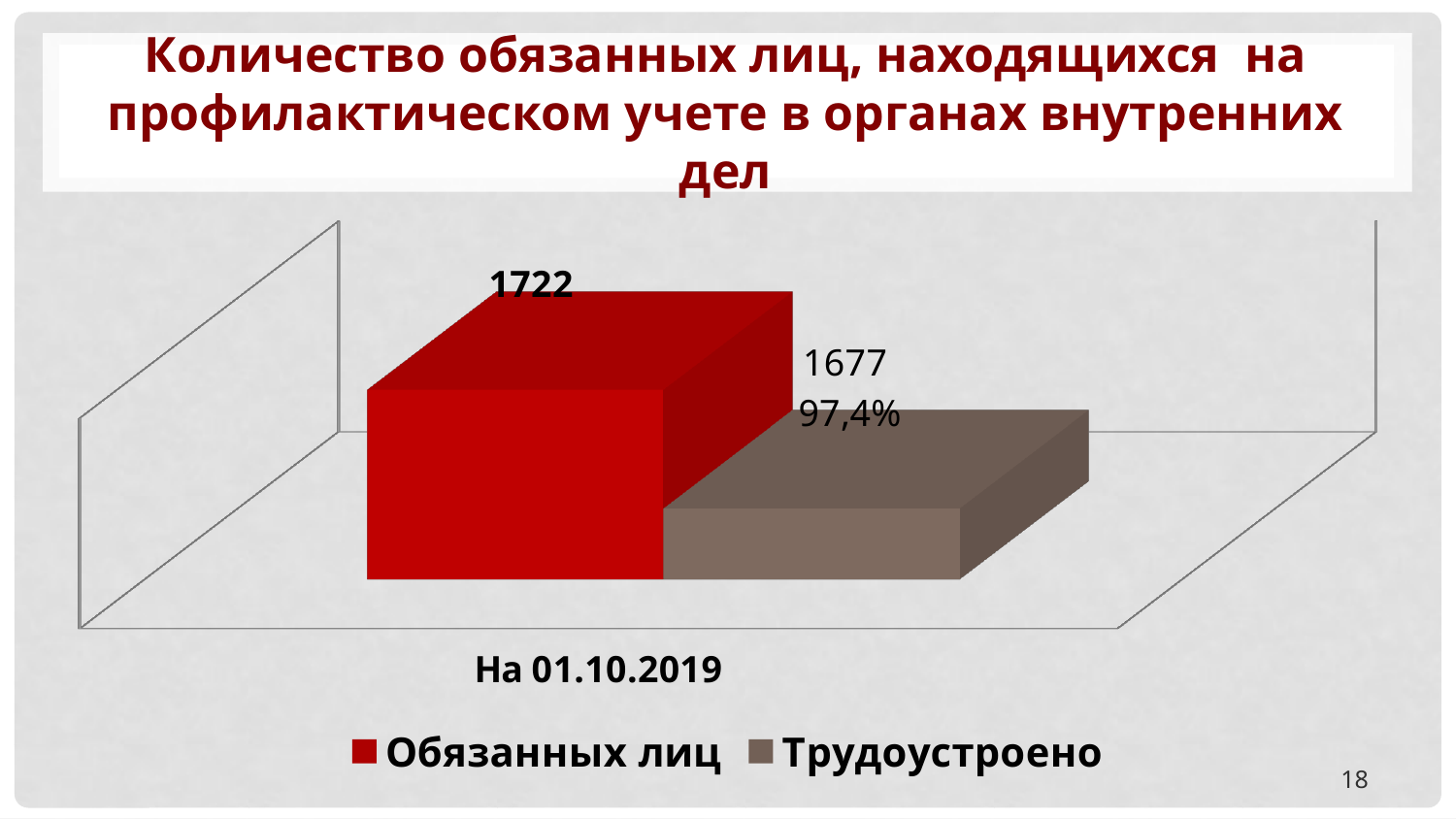
What is the value for the series "Трудоустроено" on 01.10.2019? 1677 What kind of chart is shown on the slide? Bar chart Which series has the higher value: "Обязанных лиц" or "Трудоустроено"? Обязанных лиц What colour is the bar for the series "Трудоустроено"? Brown/grey How many series does the legend list? 2 How many categories are shown on the x axis? 1 What is the category label shown on the x axis? На 01.10.2019 What percentage is shown next to the "Трудоустроено" bar? 97,4% Which series has the lowest value on the chart? Трудоустроено What is the difference between the values for "Обязанных лиц" and "Трудоустроено"? 45 What is the value for the series "Обязанных лиц" on 01.10.2019? 1722